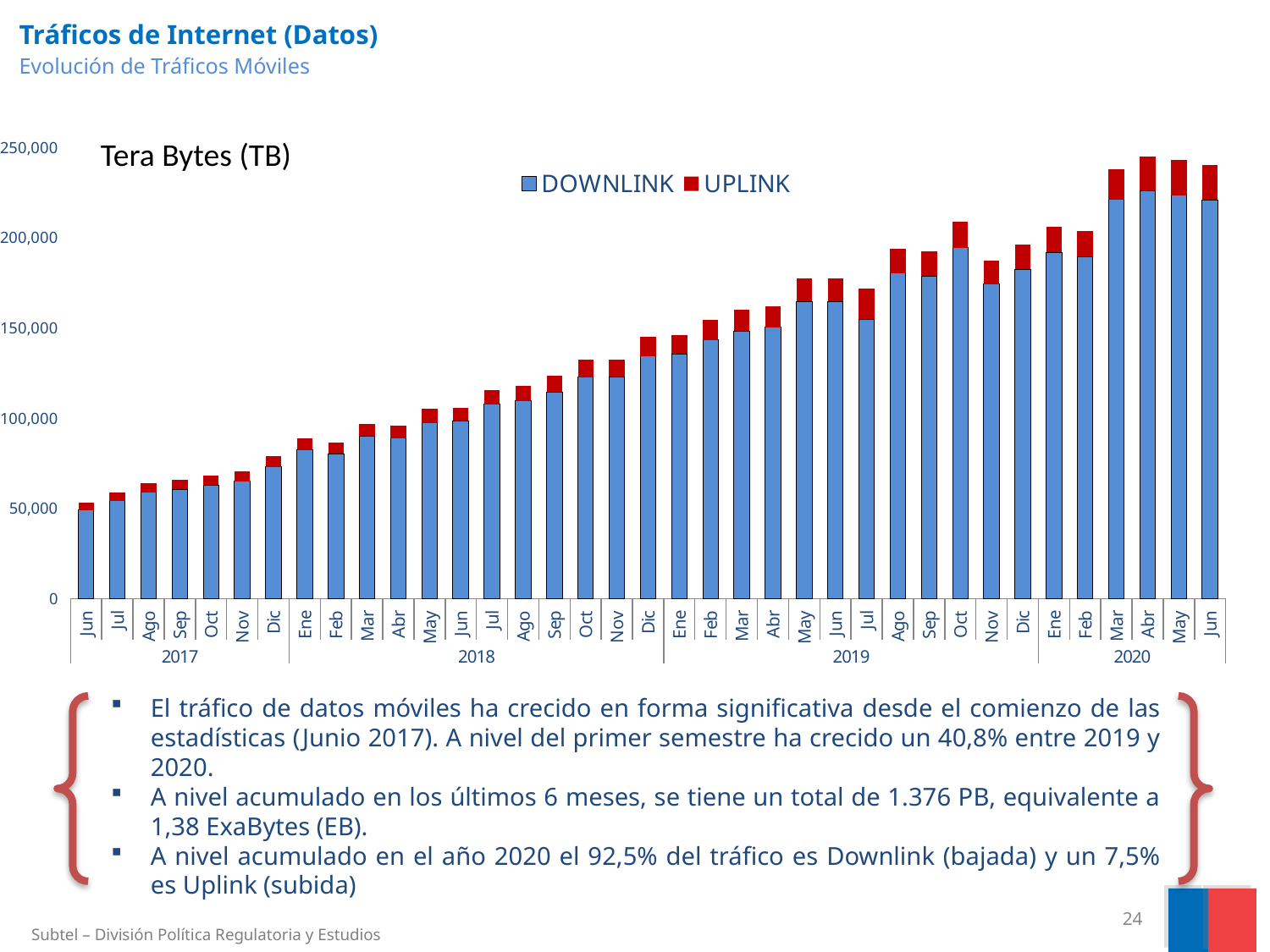
Which series is shown in red in the chart? UPLINK Is the total traffic for Mar 2020 greater or less than 200,000? greater Do the total traffic values generally rise or fall from Jun 2017 to Jun 2020? Rise How many monthly bars are plotted in the chart? 37 Which month has the highest total traffic in the chart? Abr 2020 Is the total traffic for Abr 2020 greater or less than 250,000? less Which month has the larger total traffic, Oct 2019 or Nov 2019? Oct 2019 What unit label is shown at the top left of the chart? Tera Bytes (TB) How many series does the chart legend list? 2 Is the DOWNLINK value for Dic 2017 greater or less than 100,000? less What kind of chart is shown on the slide? Stacked bar chart Which month has the lowest total traffic in the chart? Jun 2017